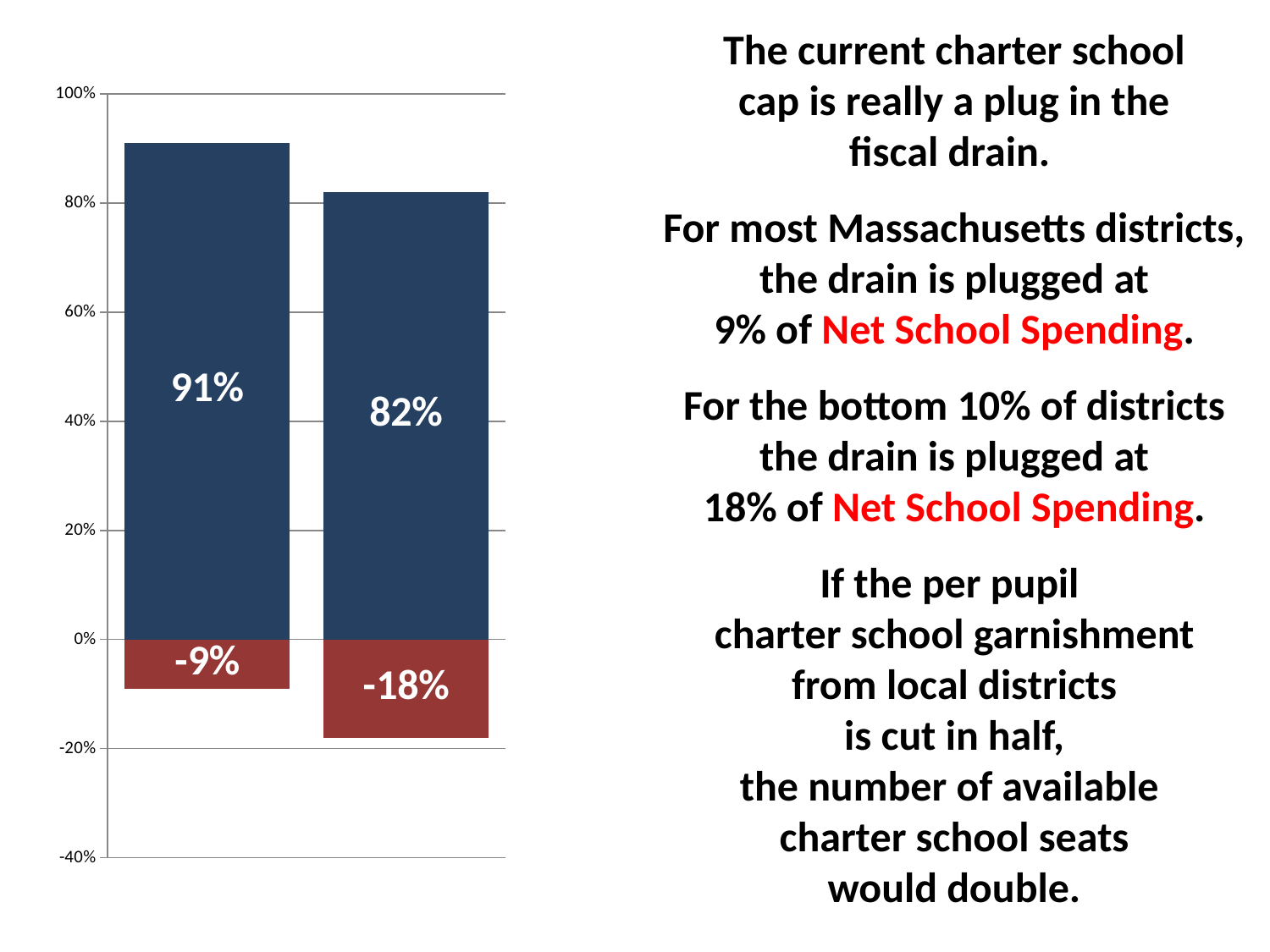
Is the dark blue segment of the right bar greater or less than 80%? greater Which bar has the larger dark blue segment, the left bar or the right bar? left bar What is the value of the dark blue segment of the left bar? 91% Which bar has the more negative red segment, the left bar or the right bar? right bar How many bars are plotted in the chart? 2 What two colours are used for the bar segments in the chart? dark blue and red What is the value of the red segment of the left bar? -9% What is the value of the dark blue segment of the right bar? 82% What type of chart is shown on the slide? bar chart What is the value of the red segment of the right bar? -18% What is the difference between the red segment values of the right bar (-18%) and the left bar (-9%)? 9% What is the difference between the dark blue segment values of the left bar (91%) and the right bar (82%)? 9%